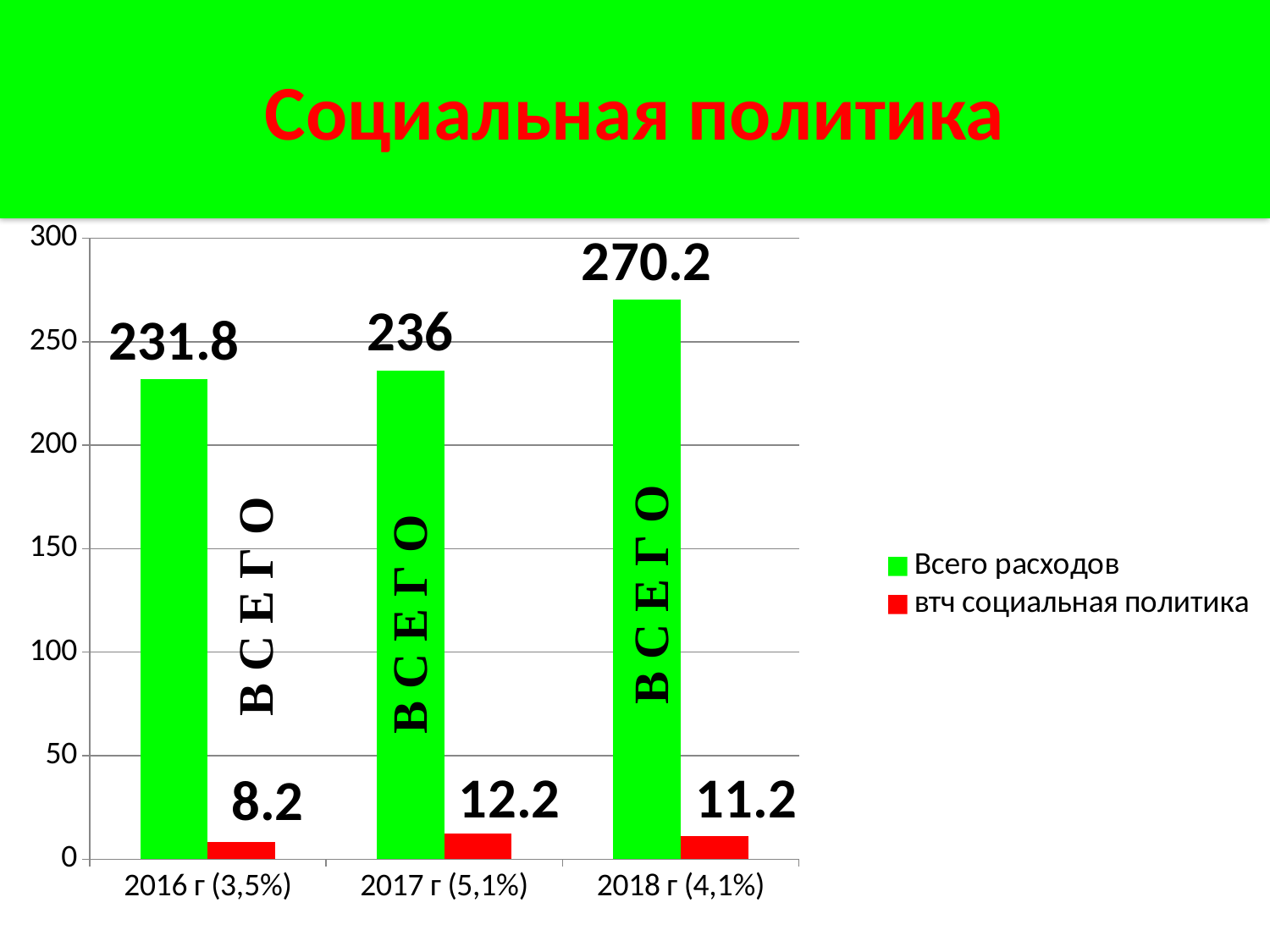
What is the value of Всего расходов for 2018 г (4,1%)? 270.2 What is the value of Всего расходов for 2016 г (3,5%)? 231.8 What is the value of втч социальная политика for 2017 г (5,1%)? 12.2 What is the difference between Всего расходов in 2018 г (4,1%) and 2017 г (5,1%)? 34.2 Does the value of Всего расходов rise or fall from 2016 to 2018? rise Which is larger: втч социальная политика in 2017 г (5,1%) or in 2018 г (4,1%)? 2017 г (5,1%) What kind of chart is shown on the slide? bar chart Which year has the lowest value for втч социальная политика? 2016 г (3,5%) Is the value of Всего расходов for 2017 г (5,1%) greater or less than 250? less How many series does the legend list? 2 Which year has the highest value for Всего расходов? 2018 г (4,1%) How many years are shown on the x axis? 3